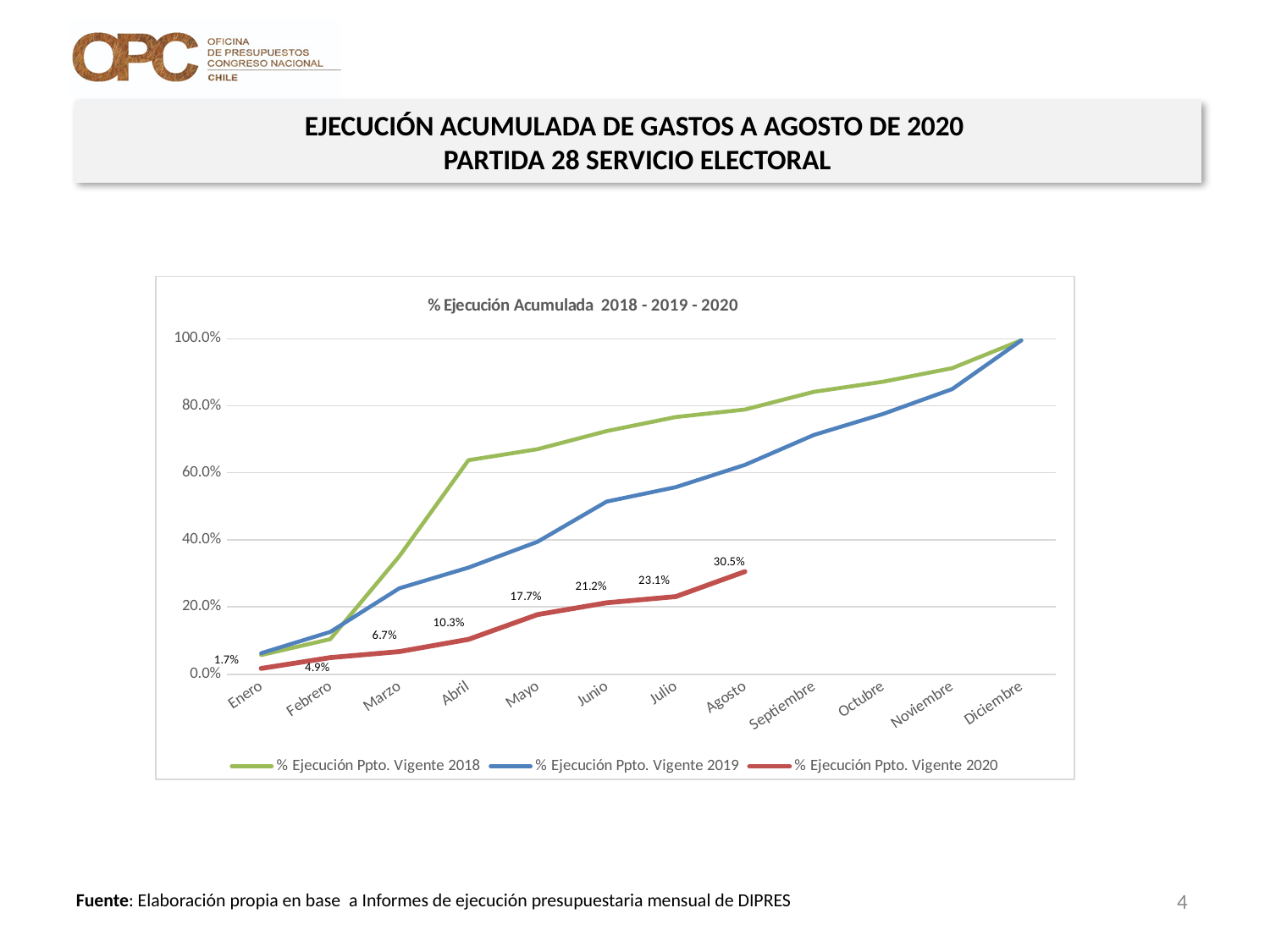
In which month does the % Ejecución Ppto. Vigente 2020 series reach its highest value? Agosto Is the value for % Ejecución Ppto. Vigente 2018 in Abril greater or less than 60.0%? greater How many months are shown on the x axis? 12 What is the value for % Ejecución Ppto. Vigente 2020 in Mayo? 17.7% How many series does the legend list? 3 What kind of chart is shown on the slide? Line chart What is the value for % Ejecución Ppto. Vigente 2020 in Enero? 1.7% Which series is higher in Agosto, % Ejecución Ppto. Vigente 2018 or % Ejecución Ppto. Vigente 2019? % Ejecución Ppto. Vigente 2018 What is the value for % Ejecución Ppto. Vigente 2020 in Agosto? 30.5% Does the % Ejecución Ppto. Vigente 2020 series rise or fall from Enero to Agosto? Rise What is the difference between the % Ejecución Ppto. Vigente 2020 values for Agosto and Julio? 7.4% In which month is the % Ejecución Ppto. Vigente 2020 series lowest? Enero